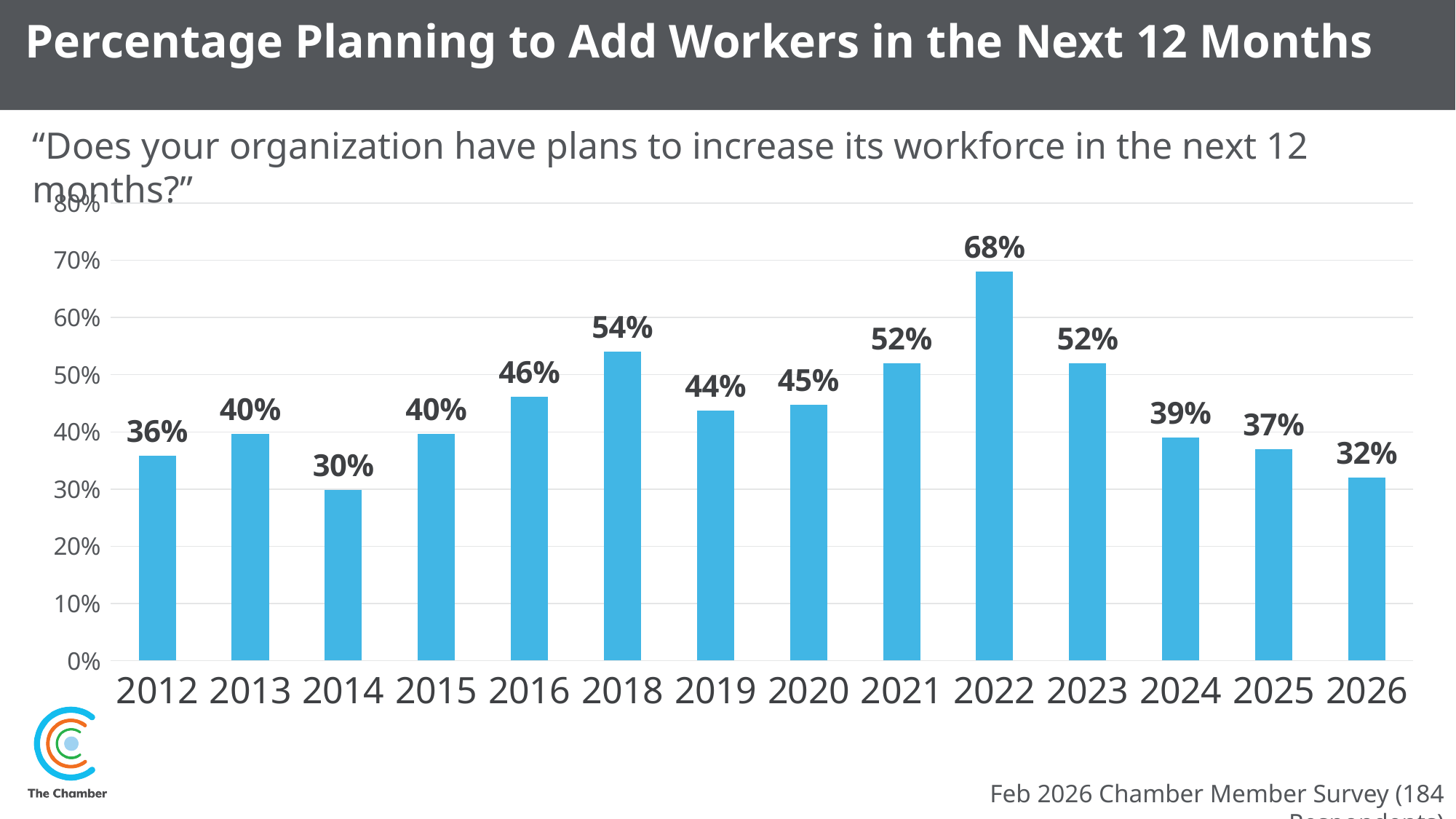
Which year has the highest percentage planning to add workers? 2022 What kind of chart is shown on the slide? Bar chart What percentage of organizations planned to add workers in 2022? 68% Is the value for 2021 greater or less than 50%? greater What is the difference between the 2022 value and the 2026 value? 36% What is the difference between the 2018 value and the 2019 value? 10% Which year has the lowest percentage planning to add workers? 2014 How many years are shown on the x axis? 14 Which year has a higher value, 2016 or 2020? 2016 Do the values rise or fall from 2022 to 2026? Fall What percentage is shown for 2026? 32% What is the value shown for 2014? 30%